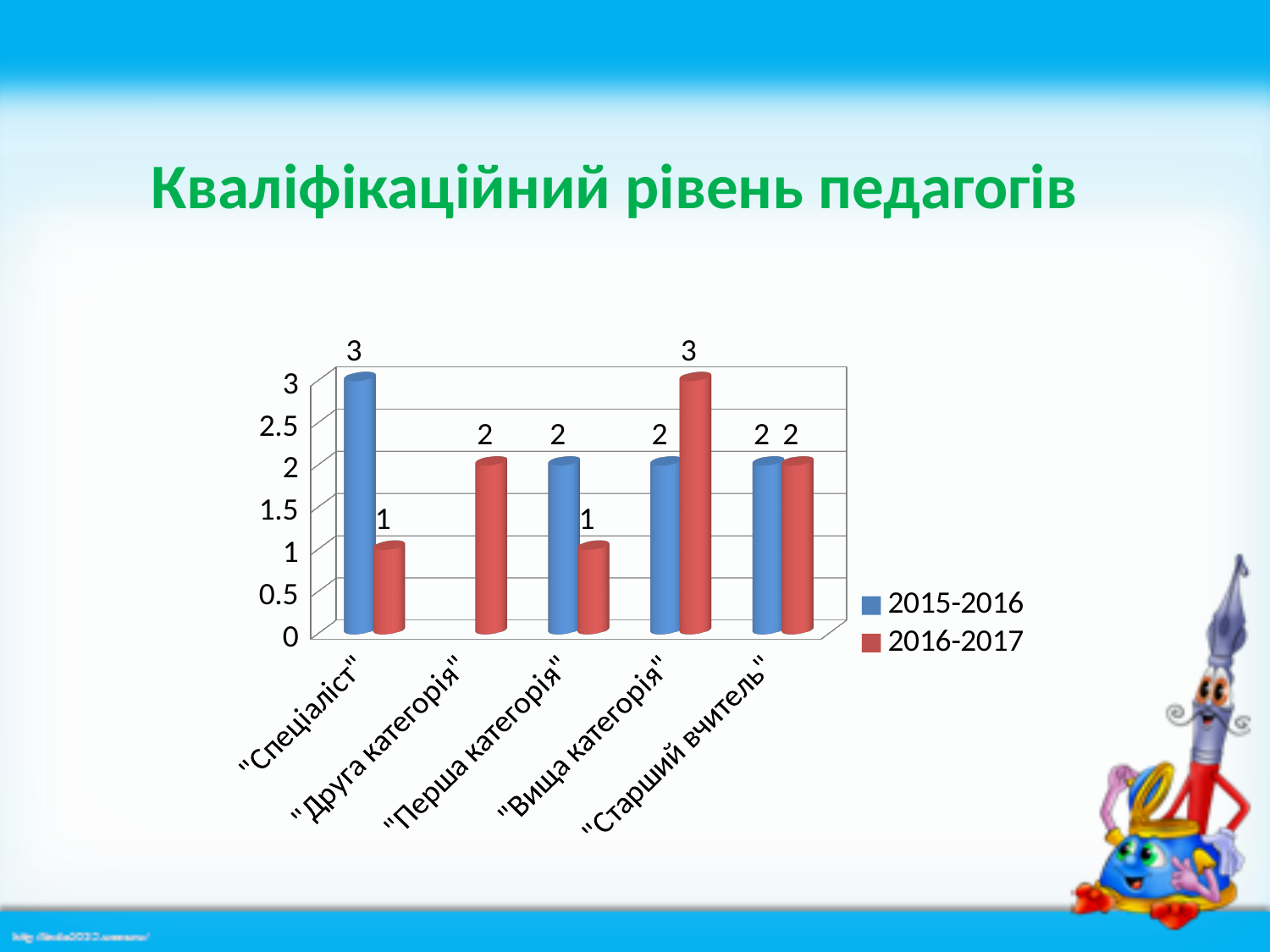
For "Вища категорія", which series has the larger value, 2015-2016 or 2016-2017? 2016-2017 What is the title of the slide? Кваліфікаційний рівень педагогів What is the difference between the 2015-2016 and 2016-2017 values for "Спеціаліст"? 2 Which category has the highest value in the 2016-2017 series? "Вища категорія" What is the value for "Перша категорія" in the 2016-2017 series? 1 Which category has the highest value in the 2015-2016 series? "Спеціаліст" What is the value for "Спеціаліст" in the 2015-2016 series? 3 How many categories are shown on the x axis? 5 How many series does the legend list? 2 What is the value for "Вища категорія" in the 2016-2017 series? 3 What kind of chart is shown on the slide? Bar chart What is the value for "Старший вчитель" in the 2015-2016 series? 2